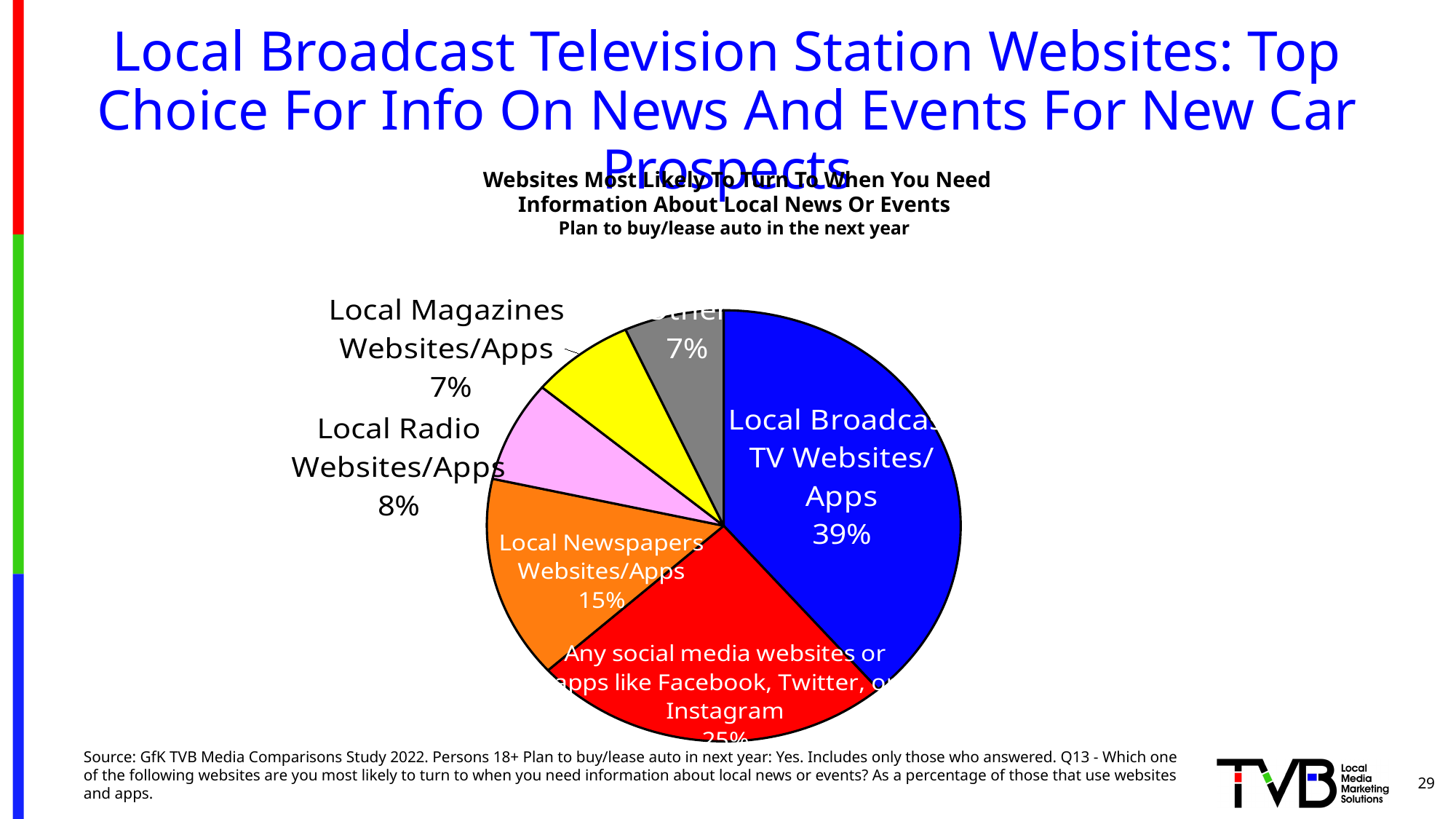
What is the difference in percentage points between Local Newspapers Websites/Apps and Local Radio Websites/Apps? 7 What percentage is shown for Local Radio Websites/Apps? 8% What percentage is shown for the Other slice? 7% Which category has the largest slice of the pie? Local Broadcast TV Websites/Apps What colour is the Local Broadcast TV Websites/Apps slice? blue What is the difference in percentage points between Local Broadcast TV Websites/Apps and Local Newspapers Websites/Apps? 24 What percentage is shown for Local Magazines Websites/Apps? 7% What kind of chart is shown on the slide? pie chart Which is larger, Local Radio Websites/Apps or Local Magazines Websites/Apps? Local Radio Websites/Apps What share of the pie is Local Broadcast TV Websites/Apps? 39% How many slices does the pie chart have? 6 What percentage is shown for Local Newspapers Websites/Apps? 15%